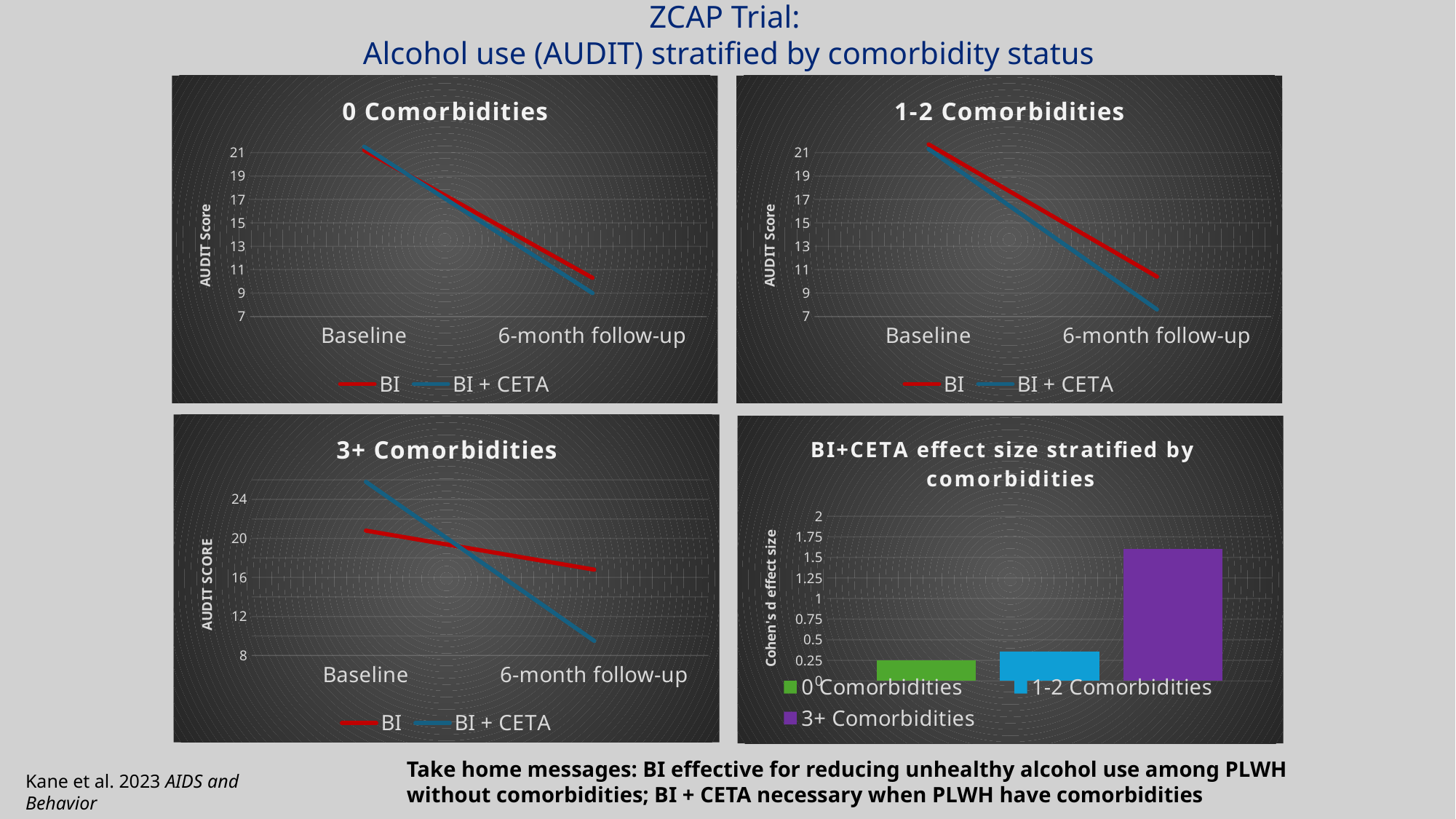
In the "BI+CETA effect size stratified by comorbidities" chart, which category has the highest effect size? 3+ Comorbidities In the "3+ Comorbidities" chart, at 6-month follow-up, which series has the higher AUDIT score, BI or BI + CETA? BI In the "BI+CETA effect size stratified by comorbidities" chart, is the value for 3+ Comorbidities greater or less than 1? greater In the "BI+CETA effect size stratified by comorbidities" chart, which category has the lowest effect size? 0 Comorbidities In the "BI+CETA effect size stratified by comorbidities" chart, is the value for 0 Comorbidities greater or less than 0.5? less In the "BI+CETA effect size stratified by comorbidities" chart, how many categories are plotted? 3 In the "0 Comorbidities" chart, does the BI line rise or fall from Baseline to 6-month follow-up? fall What kind of chart is the "0 Comorbidities" chart? line chart What kind of chart is the "BI+CETA effect size stratified by comorbidities" chart? bar chart In the "1-2 Comorbidities" chart, how many series does the legend list? 2 What is the y-axis label of the "BI+CETA effect size stratified by comorbidities" chart? Cohen's d effect size In the "3+ Comorbidities" chart, does the BI + CETA line rise or fall from Baseline to 6-month follow-up? fall